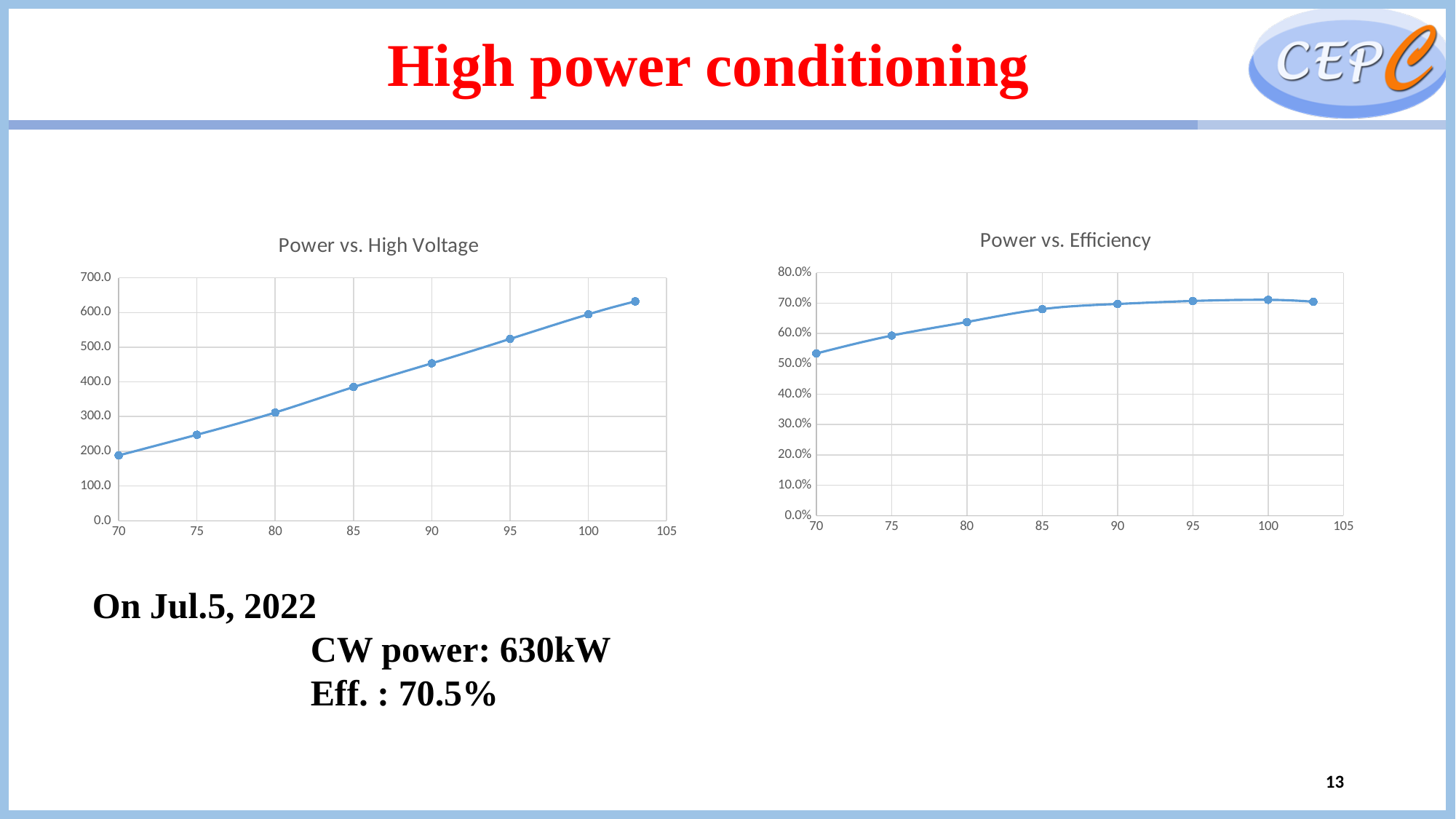
What kind of chart is the "Power vs. Efficiency" chart on the right? line chart On the "Power vs. Efficiency" chart, at which x-axis value is the efficiency lowest? 70 On the "Power vs. High Voltage" chart, do the values rise or fall as the x-axis value increases? rise What kind of chart is the "Power vs. High Voltage" chart on the left? line chart On the "Power vs. High Voltage" chart, at which x-axis value is the plotted value lowest? 70 How many data points are plotted on the "Power vs. Efficiency" chart? 8 What is the title of the chart on the right side of the slide? Power vs. Efficiency How many data points are plotted on the "Power vs. High Voltage" chart? 8 On the "Power vs. Efficiency" chart, is the value at x = 80 greater or less than 60.0%? greater On the "Power vs. High Voltage" chart, is the value at x = 90 greater or less than 400? greater On the "Power vs. High Voltage" chart, is the value at x = 95 greater or less than 500? greater